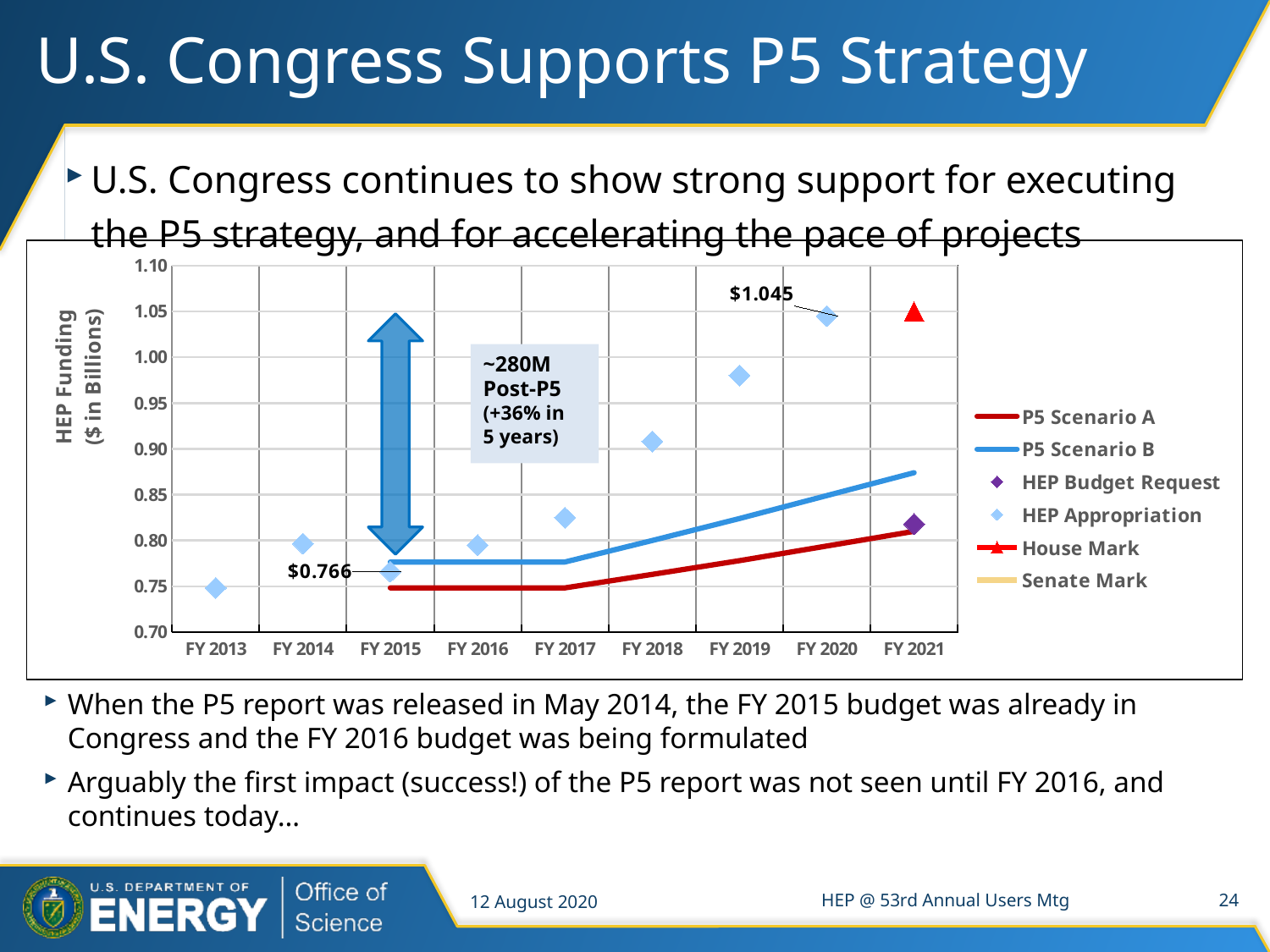
Which fiscal year has the highest HEP Appropriation point? FY 2020 What is the y-axis title of the chart? HEP Funding ($ in Billions) At FY 2021, which is larger: the House Mark or the HEP Budget Request? House Mark Is the HEP Appropriation value for FY 2019 greater or less than 0.95? greater How many series does the chart legend list? 6 Which fiscal year has the lowest HEP Appropriation point? FY 2013 What is the difference between the labelled HEP Appropriation values for FY 2020 and FY 2015? $0.279 Do the HEP Appropriation points rise or fall from FY 2016 to FY 2020? rise How many fiscal years are shown on the x axis? 9 Is the HEP Appropriation value for FY 2013 greater or less than 0.80? less What is the HEP Appropriation value labelled for FY 2020? $1.045 What is the HEP Appropriation value labelled for FY 2015? $0.766